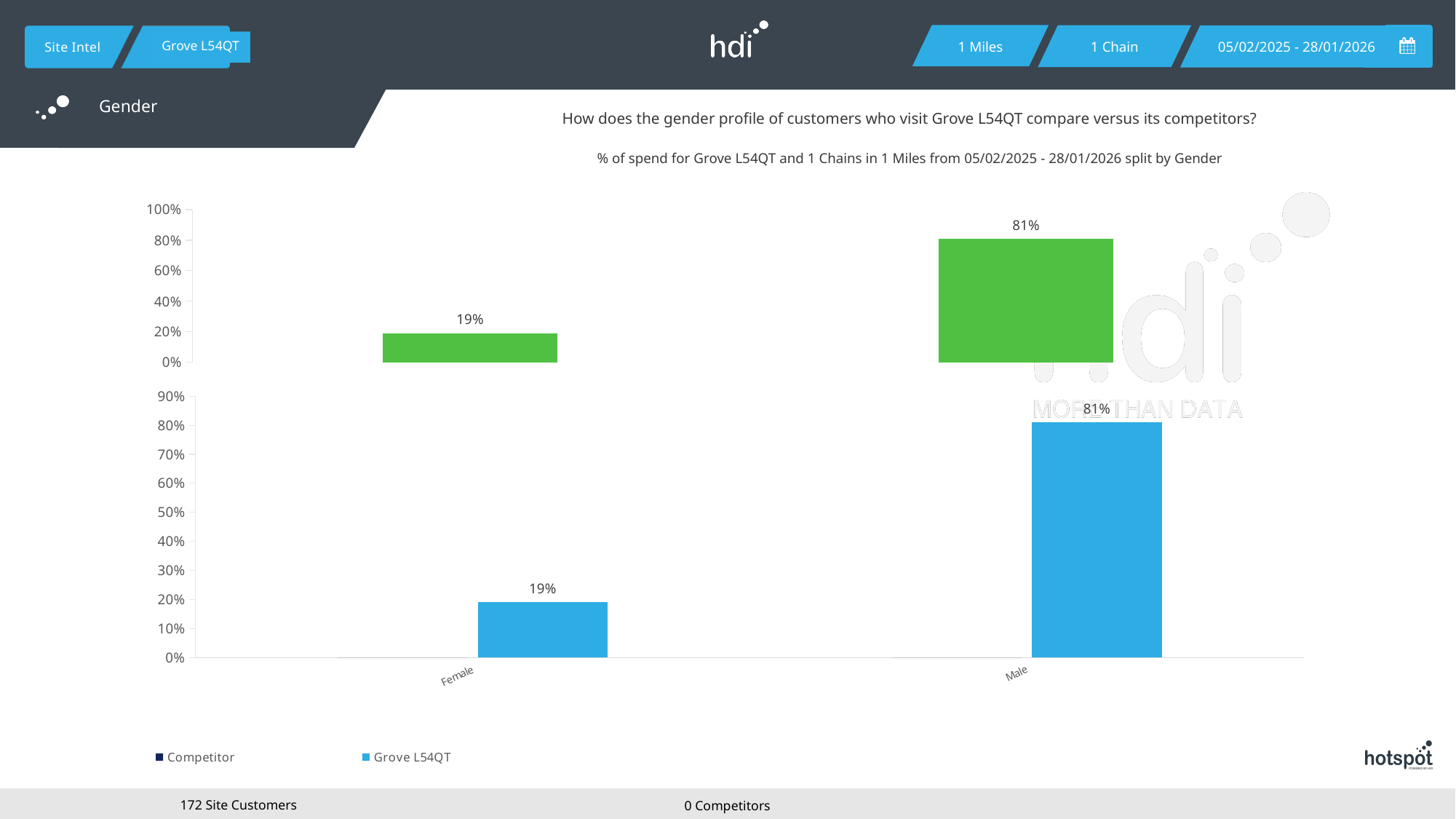
In the bottom chart, what is the value for Female? 19% In the top chart, what is the value for Female? 19% In the bottom chart, which category has the highest value? Male In the top chart, what is the value for Male? 81% How many series does the legend at the bottom of the slide list? 2 How many categories are shown on the x axis of the bottom chart? 2 In the top chart, which is larger, the value for Female or the value for Male? Male What is the highest tick value on the y axis of the bottom chart? 90% In the bottom chart, what is the value for Male? 81% What kind of chart is the bottom chart? bar chart In the top chart, which category has the lowest value? Female In the bottom chart, what is the difference between the Male and Female values? 62%